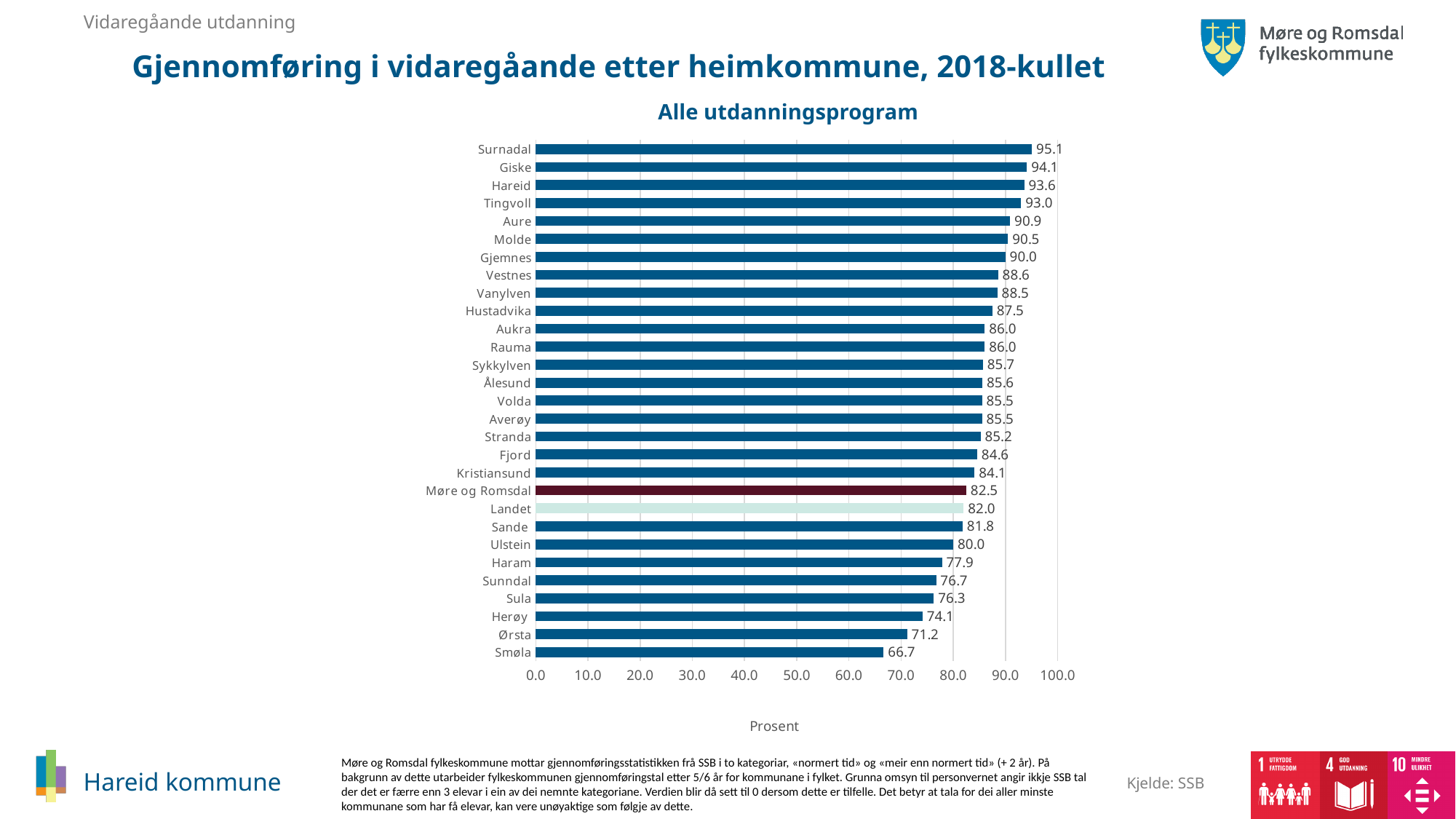
What is the value for Landet? 82.0 How many categories are shown on the chart? 29 Which has a larger value, Molde or Ålesund? Molde What is the title of the chart? Alle utdanningsprogram What is the difference between the values for Hareid and Landet? 11.6 What is the value for Hareid? 93.6 Which category has the highest value? Surnadal Is the value for Ørsta greater or less than 80.0? less What is the value for Møre og Romsdal? 82.5 What kind of chart is shown on the slide? bar chart Which category has the lowest value? Smøla What is the difference between the values for Surnadal and Smøla? 28.4